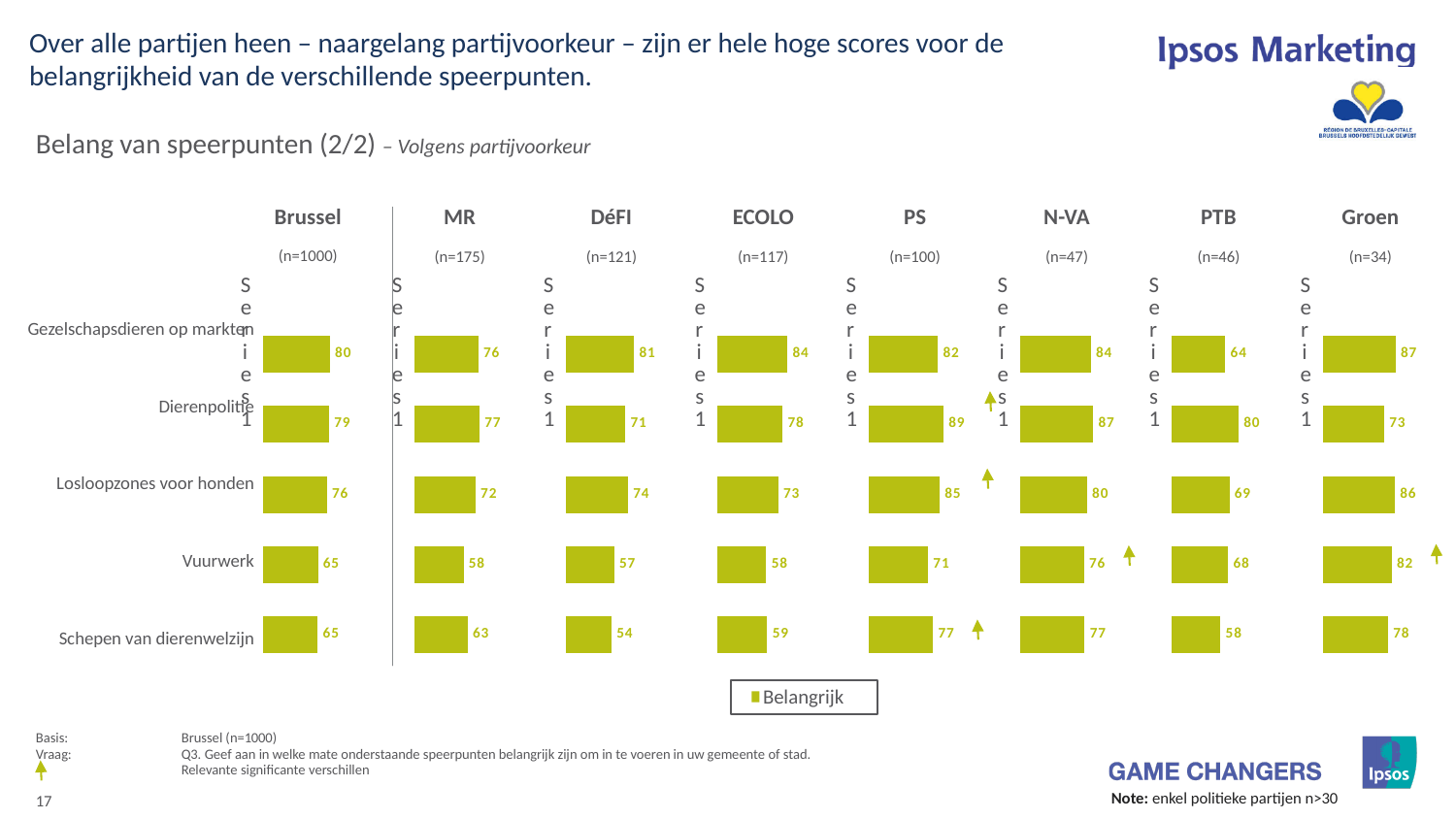
In the ECOLO chart, which is larger: Gezelschapsdieren op markten or Losloopzones voor honden? Gezelschapsdieren op markten What kind of chart is used for each party column? Bar chart In the DéFI chart, which category has the lowest value? Schepen van dierenwelzijn What series name does the legend show? Belangrijk What is the sample size (n) shown for the Groen chart? n=34 In the Brussel chart, do the values rise or fall from Gezelschapsdieren op markten down to Schepen van dierenwelzijn? Fall In the Brussel chart, what is the value for Gezelschapsdieren op markten? 80 In the Groen chart, what is the value for Vuurwerk? 82 In the MR chart, how many categories are shown? 5 In the PTB chart, which category has the highest value? Dierenpolitie In the PS chart, what is the value for Dierenpolitie? 89 In the N-VA chart, what is the difference between Dierenpolitie and Vuurwerk? 11